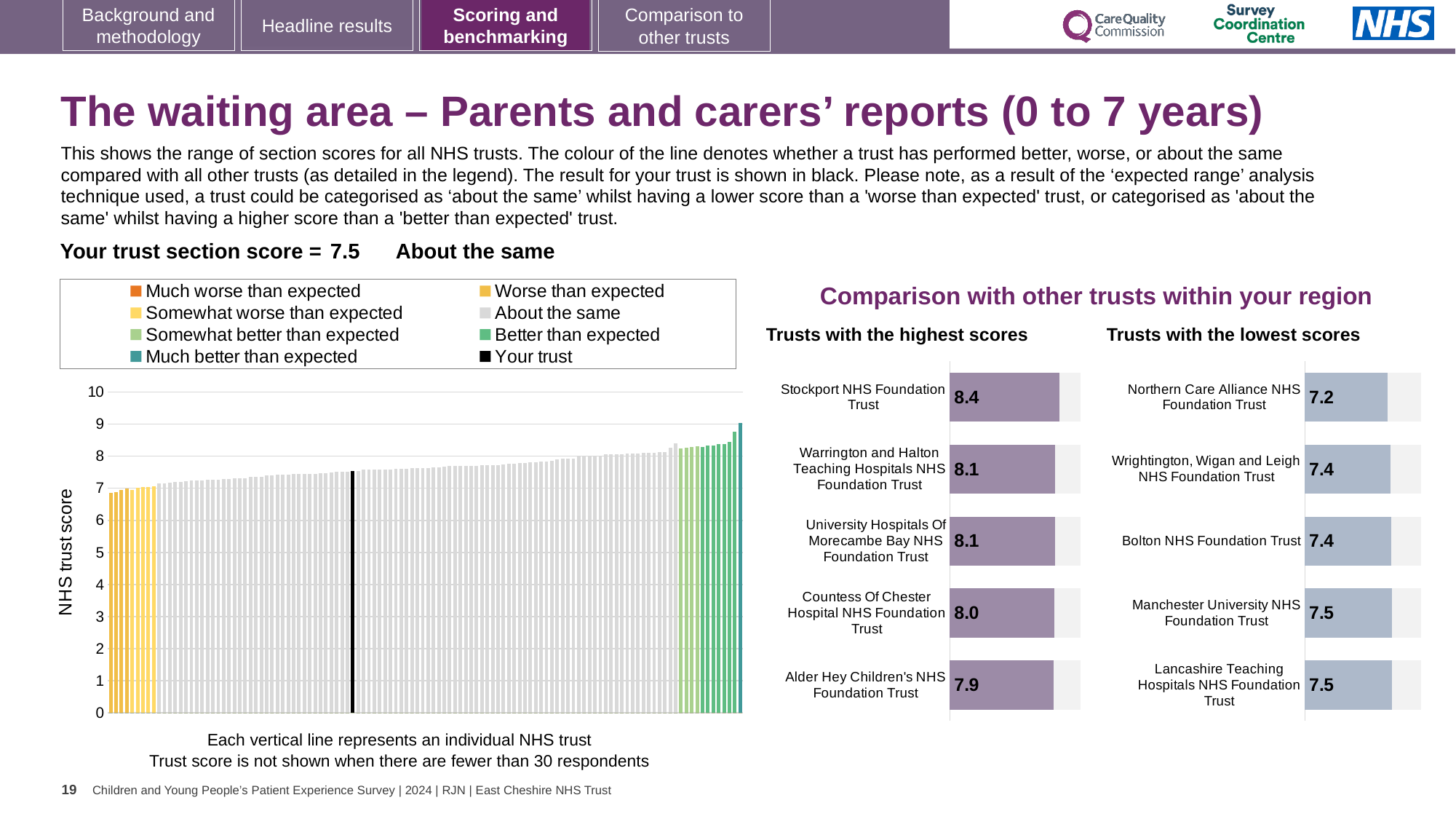
How many entries does the legend above the large chart on the left list? 8 In the 'Trusts with the lowest scores' chart, what is the score for Bolton NHS Foundation Trust? 7.4 In the large chart on the left, do the trust scores rise or fall from left to right along the x axis? rise In the 'Trusts with the highest scores' chart, what is the difference between the scores of Stockport NHS Foundation Trust and Alder Hey Children's NHS Foundation Trust? 0.5 In the 'Trusts with the highest scores' chart, which trust has the lowest score? Alder Hey Children's NHS Foundation Trust In the large chart on the left, is the value of the tallest bar greater or less than 8? greater In the 'Trusts with the lowest scores' chart, what is the difference between the scores of Lancashire Teaching Hospitals NHS Foundation Trust and Northern Care Alliance NHS Foundation Trust? 0.3 How many trusts are shown in the 'Trusts with the highest scores' chart? 5 What is the section score for your trust shown on the slide? 7.5 In the 'Trusts with the highest scores' chart, what is the score for Stockport NHS Foundation Trust? 8.4 In the 'Trusts with the lowest scores' chart, which trust has the lowest score? Northern Care Alliance NHS Foundation Trust What kind of chart is the large chart on the left showing NHS trust scores? bar chart